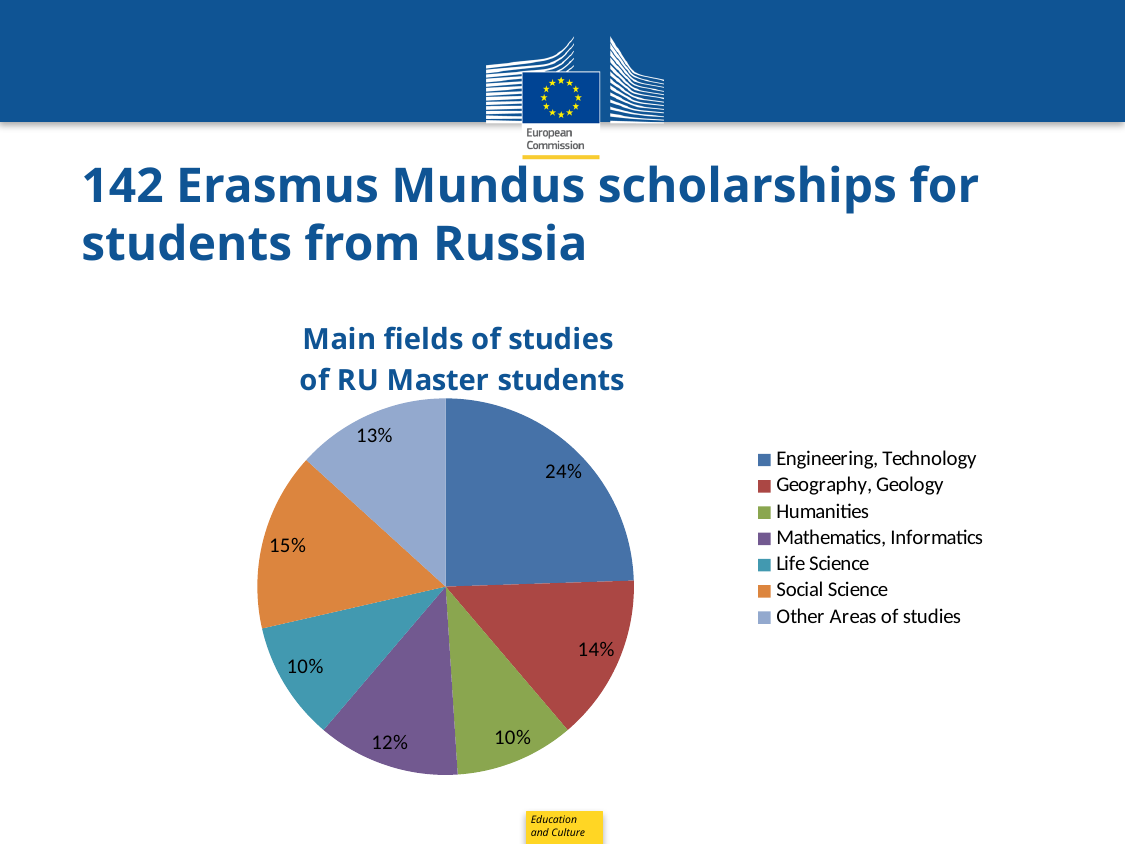
Which has a larger share, Social Science or Mathematics, Informatics? Social Science What kind of chart is shown on the slide? Pie chart What share of the pie does Engineering, Technology represent? 24% What percentage is shown for Mathematics, Informatics? 12% Which field of study has the largest share of the pie? Engineering, Technology What percentage is shown for Geography, Geology? 14% How many categories does the legend list? 7 What is the difference in percentage points between Engineering, Technology and Geography, Geology? 10 Which two fields of study each have a 10% share? Humanities and Life Science What percentage is shown for Other Areas of studies? 13% What is the title of the chart? Main fields of studies of RU Master students What percentage is shown for Social Science? 15%